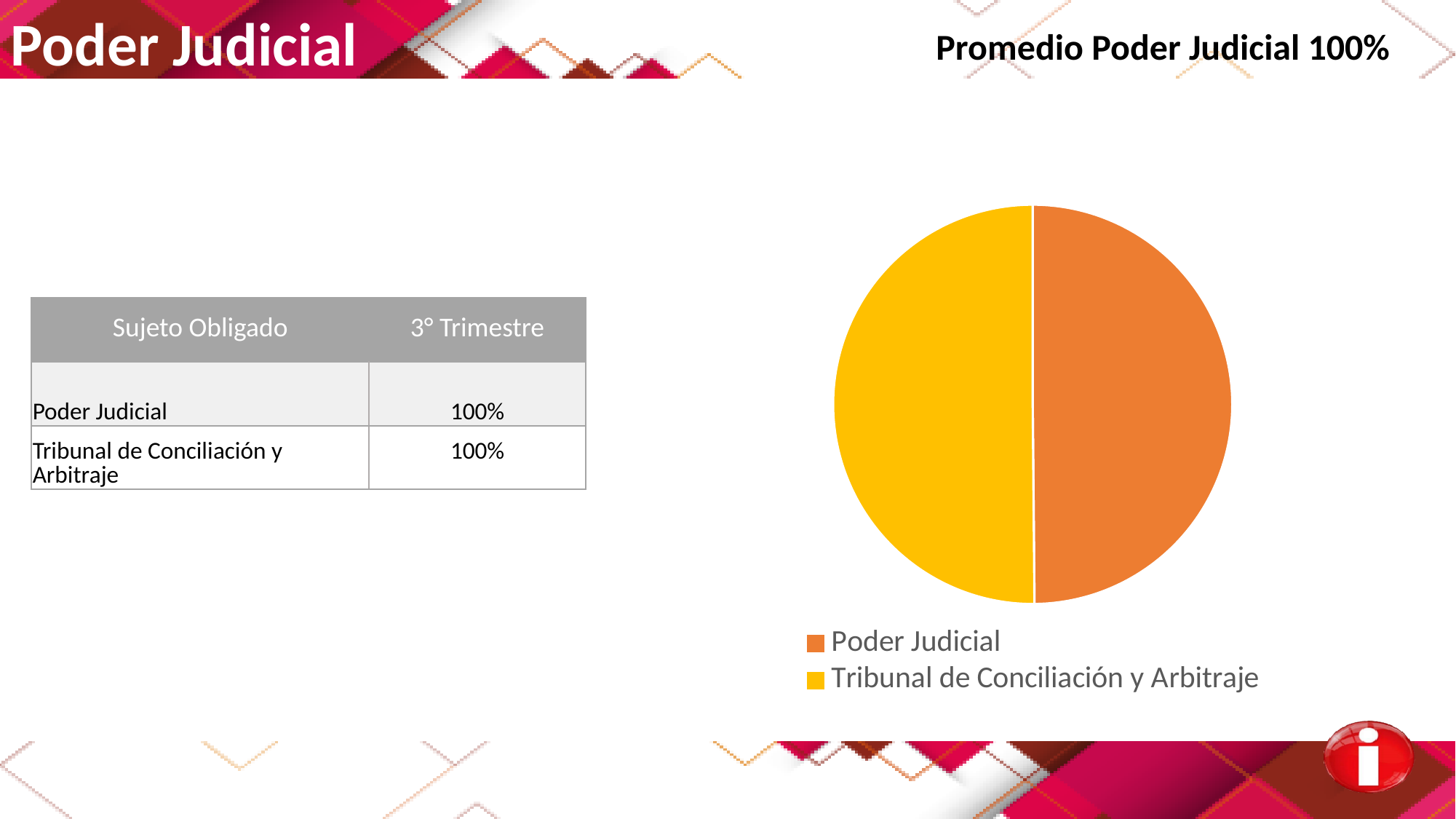
Is the value for Poder Judicial greater or less than 50%? greater What is the 3° Trimestre value for Tribunal de Conciliación y Arbitraje? 100% How many slices does the pie chart have? 2 What is the 3° Trimestre value for Poder Judicial? 100% Which colour represents Poder Judicial in the pie chart? orange How many entries does the pie chart's legend list? 2 What kind of chart is shown on the slide? pie chart Which colour represents Tribunal de Conciliación y Arbitraje in the pie chart? yellow What is the difference between the values for Poder Judicial and Tribunal de Conciliación y Arbitraje? 0%